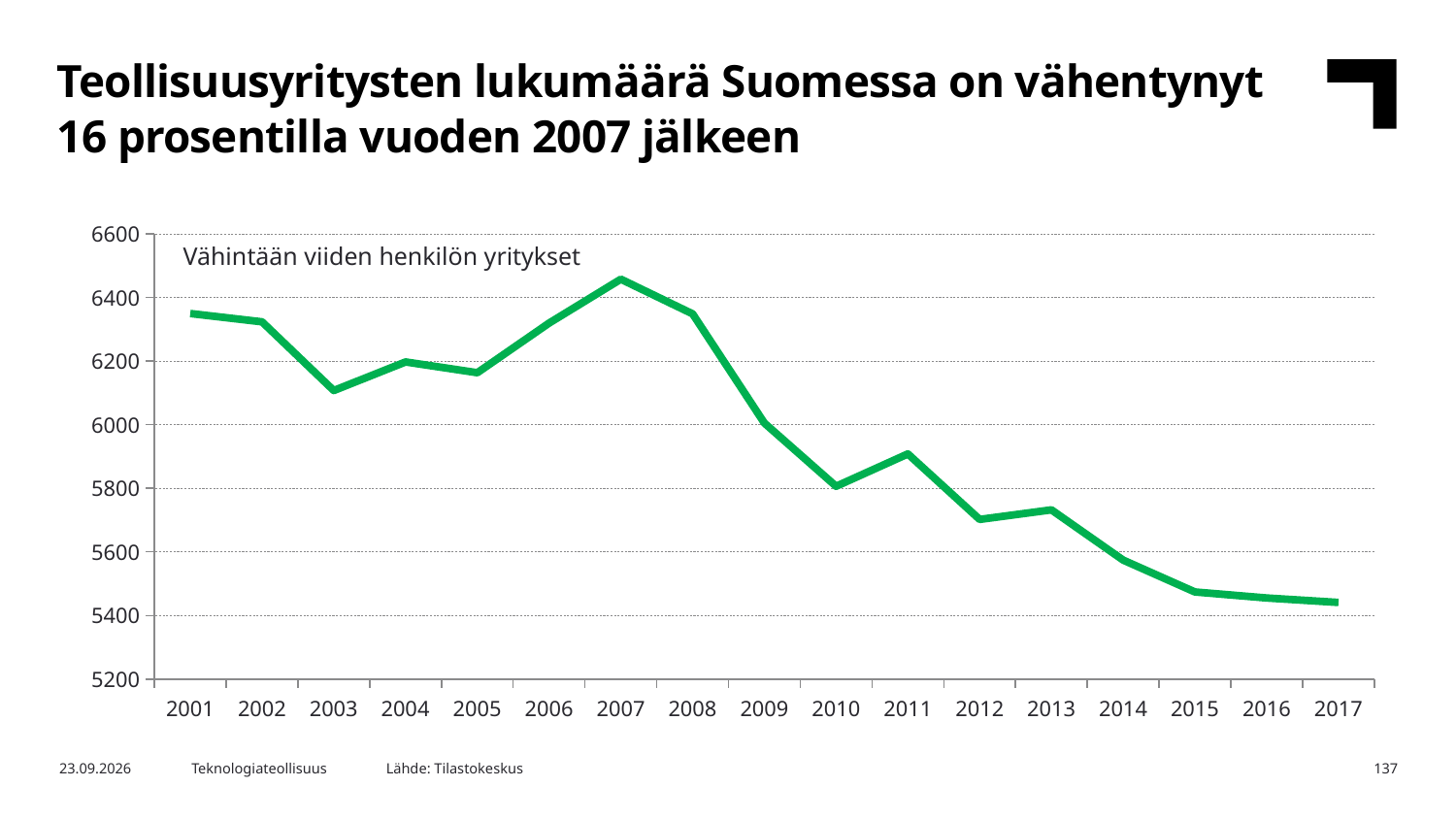
What kind of chart is shown on the slide? line chart Which year has the larger value, 2001 or 2017? 2001 How many years are plotted on the x axis of the chart? 17 Is the value for 2007 greater or less than 6400? greater Is the value for 2003 greater or less than 6200? less Does the line generally rise or fall from 2007 to 2017? fall Which year has the larger value, 2008 or 2010? 2008 In which year does the number of industrial companies reach its highest point? 2007 Is the value for 2011 greater or less than 6000? less What text label is shown inside the plot area describing the series? Vähintään viiden henkilön yritykset